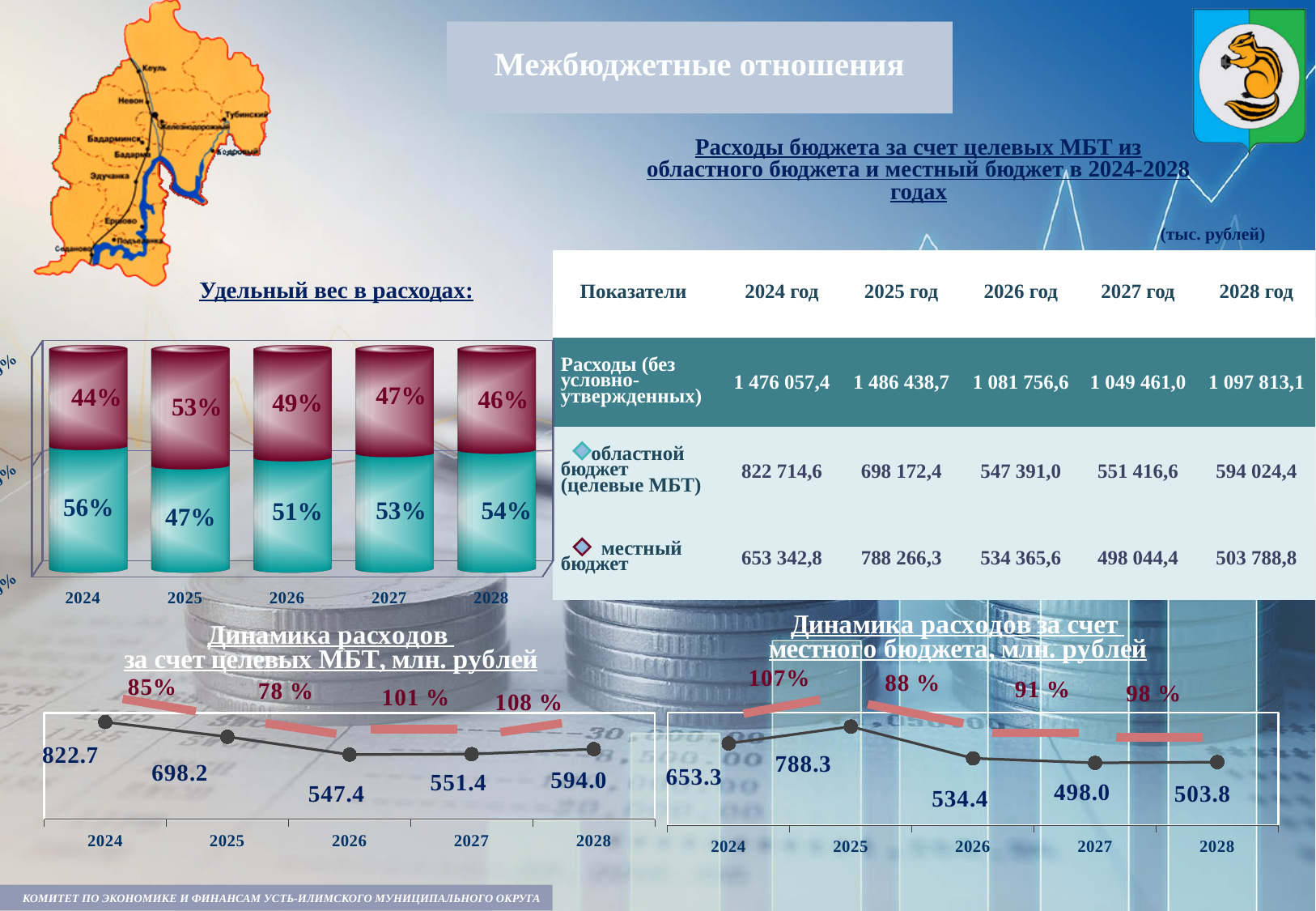
In the chart 'Динамика расходов за счет местного бюджета, млн. рублей', what is the value for 2025? 788.3 In the chart 'Динамика расходов за счет целевых МБТ, млн. рублей', what is the value for 2024? 822.7 In the chart 'Динамика расходов за счет местного бюджета, млн. рублей', what is the difference between the 2025 and 2026 values? 253.9 In the chart 'Динамика расходов за счет целевых МБТ, млн. рублей', how many data points are plotted? 5 In the chart 'Удельный вес в расходах:', what is the value of the red (top) segment for 2025? 53% In the chart 'Динамика расходов за счет целевых МБТ, млн. рублей', which year has the lowest value? 2026 What kind of chart is 'Динамика расходов за счет местного бюджета, млн. рублей'? line chart What kind of chart is 'Удельный вес в расходах:'? stacked bar chart In the chart 'Динамика расходов за счет целевых МБТ, млн. рублей', what is the difference between the 2024 and 2028 values? 228.7 In the chart 'Динамика расходов за счет местного бюджета, млн. рублей', which is larger: the value for 2027 or the value for 2028? 2028 In the chart 'Динамика расходов за счет местного бюджета, млн. рублей', which year has the highest value? 2025 In the chart 'Удельный вес в расходах:', what is the value of the teal (bottom) segment for 2024? 56%